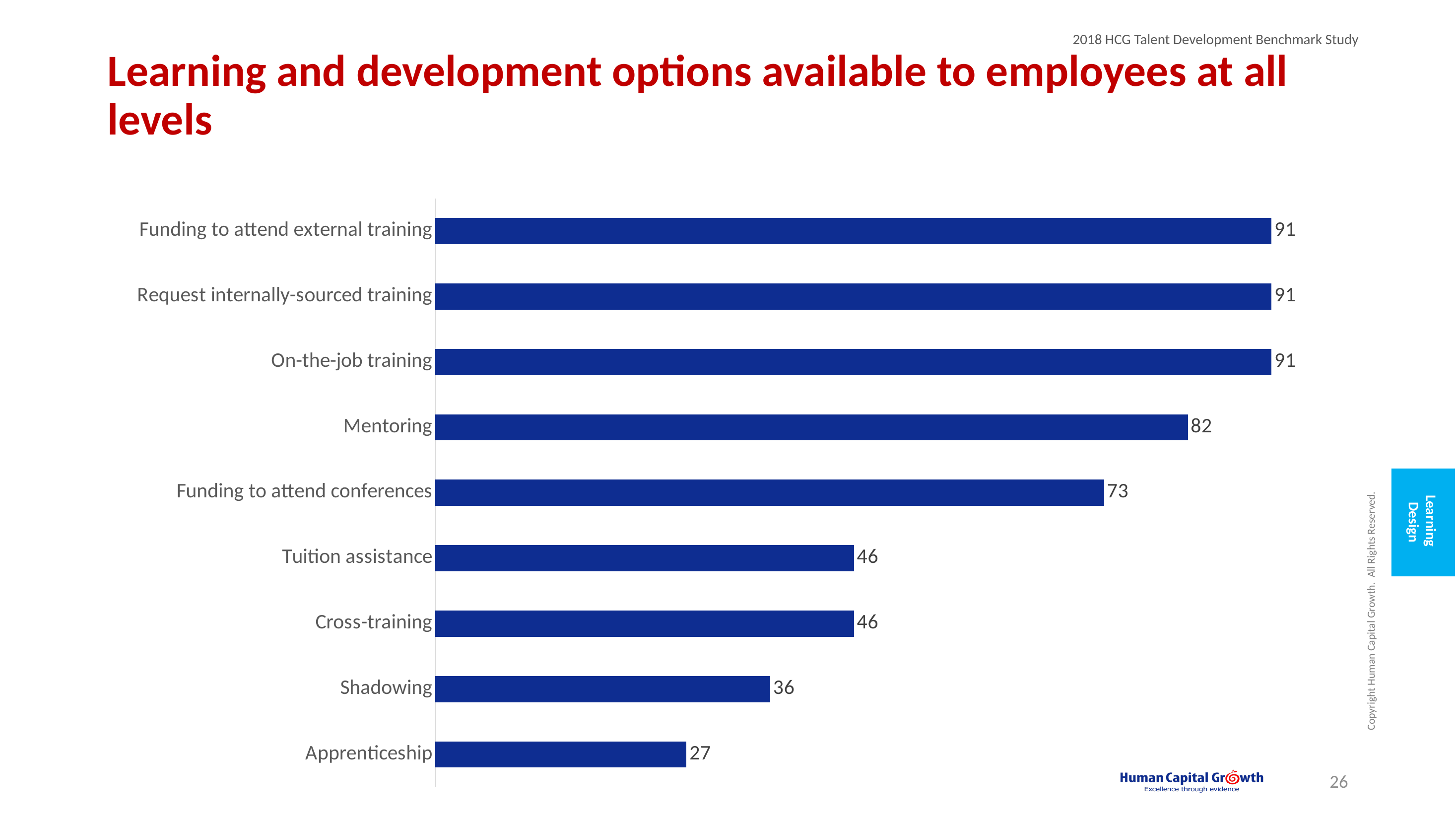
What is the difference between the values for On-the-job training and Apprenticeship? 64 What is the difference between the values for Mentoring and Funding to attend conferences? 9 How many categories are shown in the chart? 9 What is the value for Funding to attend conferences? 73 Which category has the lowest value? Apprenticeship How many categories share the highest value of 91? 3 Which is larger, the value for Tuition assistance or the value for Shadowing? Tuition assistance What is the value for Shadowing? 36 Which is larger, the value for Funding to attend conferences or the value for Cross-training? Funding to attend conferences What is the value for Mentoring? 82 What kind of chart is shown on the slide? Bar chart What is the value for Apprenticeship? 27